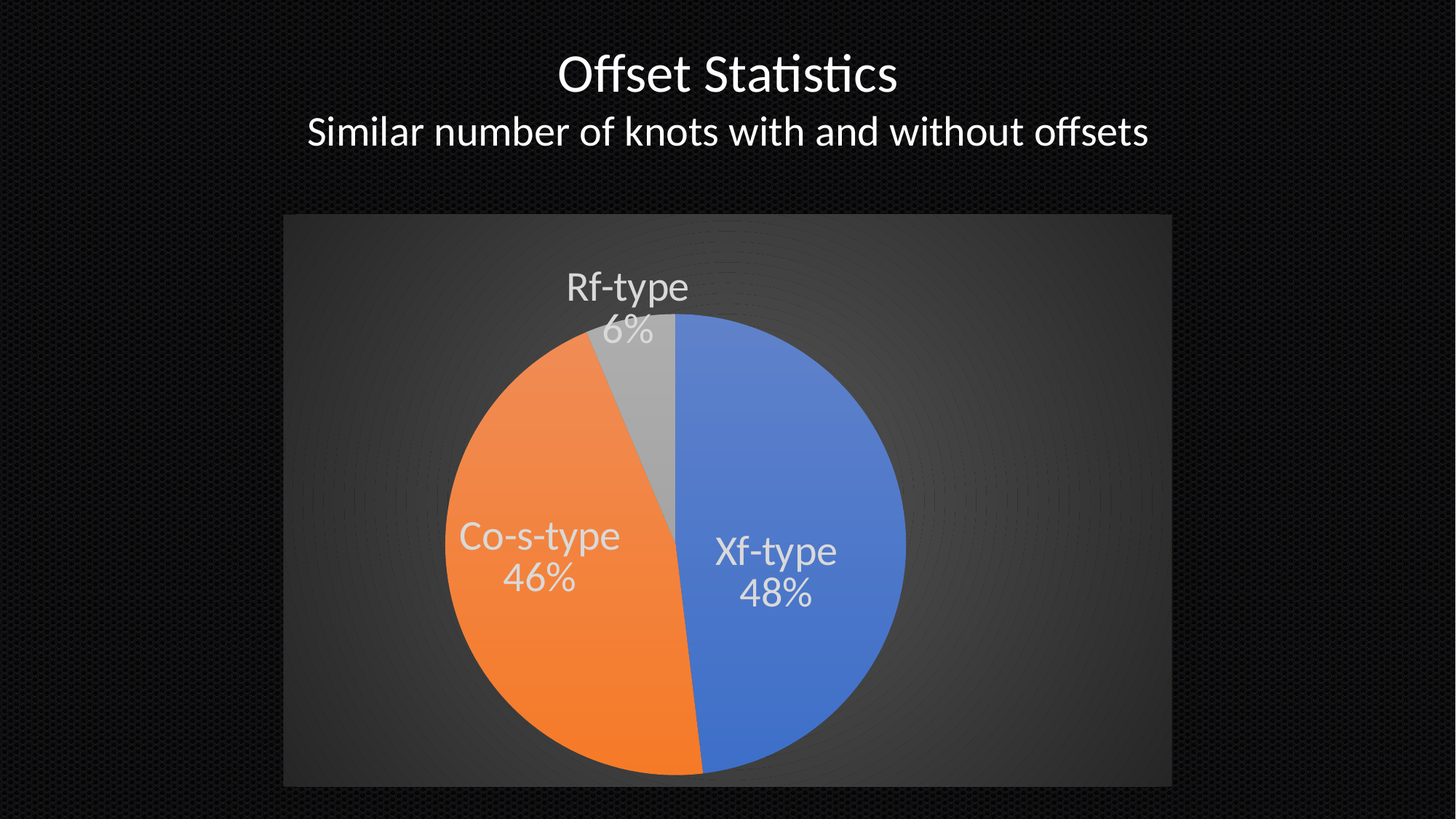
Which category has the smallest slice of the pie? Rf-type Which is larger, the Co-s-type slice or the Rf-type slice? Co-s-type What is the difference in percentage points between Co-s-type and Rf-type? 40% What colour is the Xf-type slice? blue What kind of chart is shown on the slide? pie chart What share of the pie does Co-s-type have? 46% Which category has the largest slice of the pie? Xf-type What is the difference in percentage points between Xf-type and Co-s-type? 2% What share of the pie does Rf-type have? 6% What share of the pie does Xf-type have? 48% What is the title of the slide containing the pie chart? Offset Statistics How many slices does the pie chart have? 3